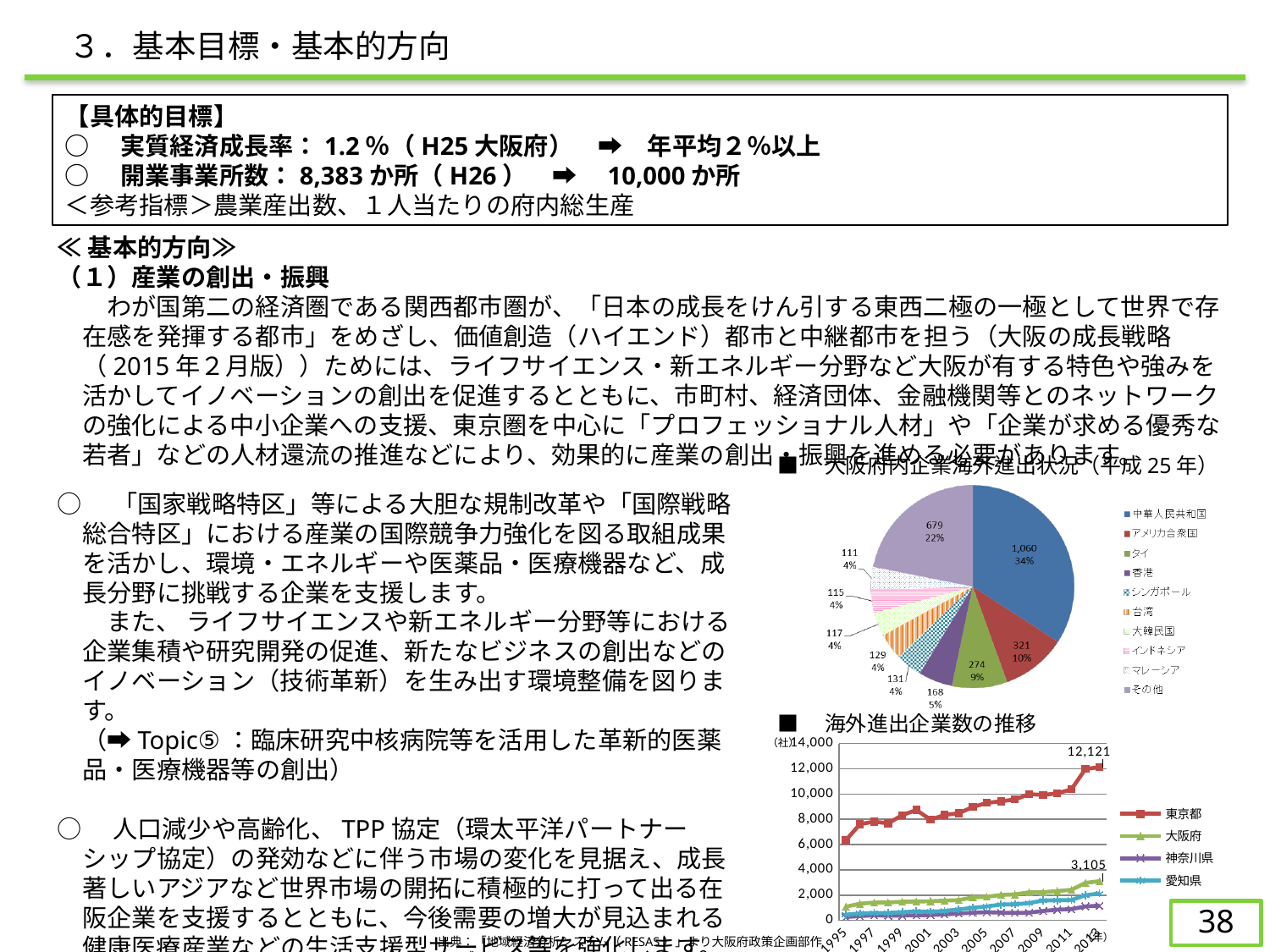
In the pie chart 大阪府内企業海外進出状況（平成25年）, which country has the largest slice? 中華人民共和国 In the chart 海外進出企業数の推移, what is the value labelled for 大阪府 in 2013? 3,105 In the chart 海外進出企業数の推移, what is the value labelled for 東京都 in 2013? 12,121 How many series does the legend of the chart 海外進出企業数の推移 list? 4 In the chart 海外進出企業数の推移, is the value for 東京都 in 1995 greater or less than 8,000? less What kind of chart is 海外進出企業数の推移? line chart In the pie chart 大阪府内企業海外進出状況（平成25年）, what is the value shown for 中華人民共和国? 1,060 How many entries does the legend of the pie chart 大阪府内企業海外進出状況（平成25年） list? 10 In the pie chart 大阪府内企業海外進出状況（平成25年）, what share is shown for アメリカ合衆国? 10% What kind of chart is 大阪府内企業海外進出状況（平成25年）? pie chart In the pie chart 大阪府内企業海外進出状況（平成25年）, what is the difference between the values for 中華人民共和国 and アメリカ合衆国? 739 In the pie chart 大阪府内企業海外進出状況（平成25年）, what share of the pie does 中華人民共和国 account for? 34%